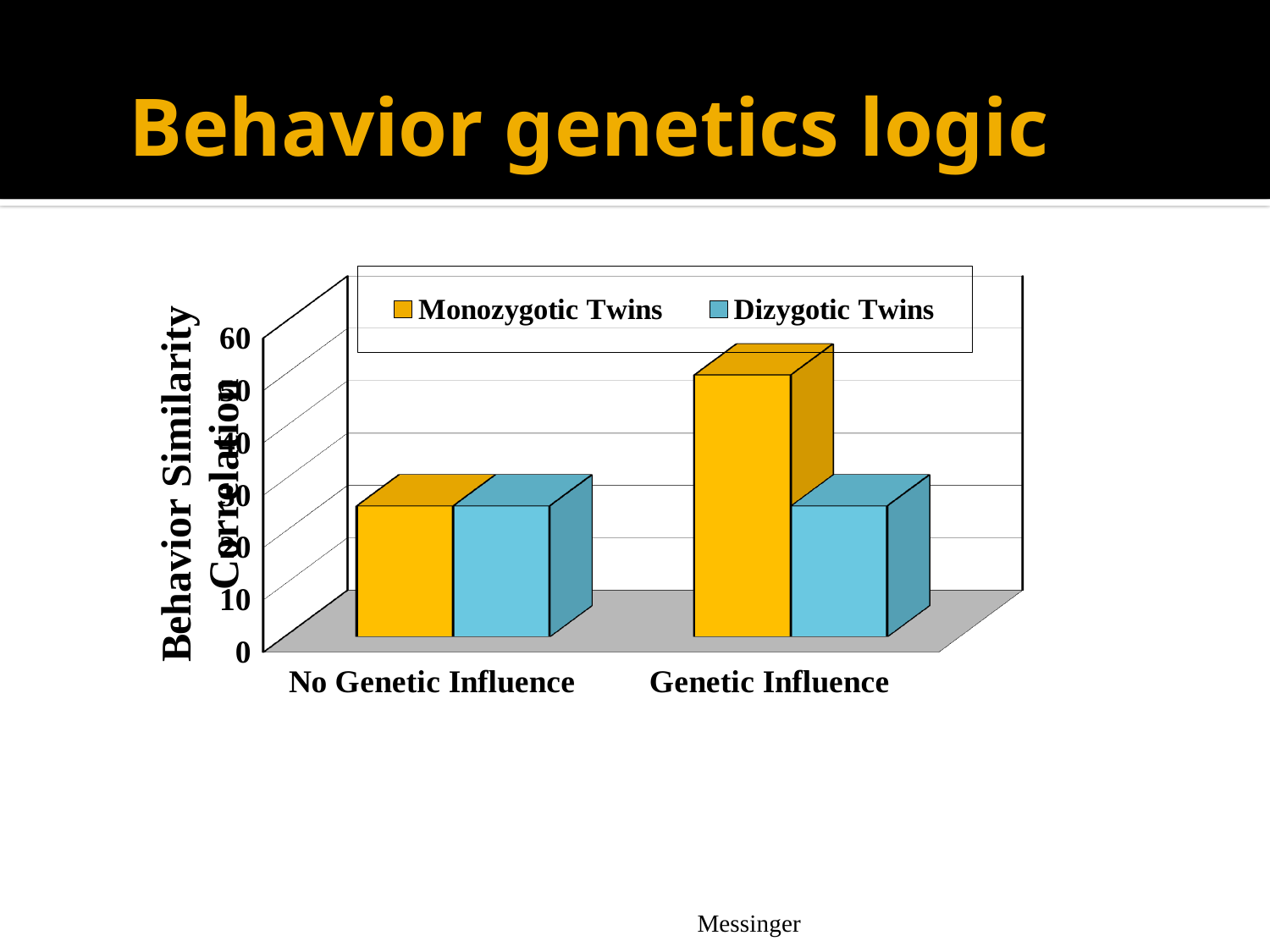
Is the value for Dizygotic Twins under Genetic Influence greater or less than 40? less Is the value for Dizygotic Twins under No Genetic Influence greater or less than 10? greater What is the label on the vertical axis of the chart? Behavior Similarity Correlation How many categories are shown along the x axis of the chart? 2 What kind of chart is shown on the slide? bar chart How many series does the chart legend list? 2 Which series has the tallest bar in the chart? Monozygotic Twins What colour represents Dizygotic Twins in the chart legend? blue Under Genetic Influence, which is larger: the Monozygotic Twins bar or the Dizygotic Twins bar? Monozygotic Twins Is the value for Monozygotic Twins under No Genetic Influence greater or less than 40? less Which category has the highest Monozygotic Twins bar? Genetic Influence